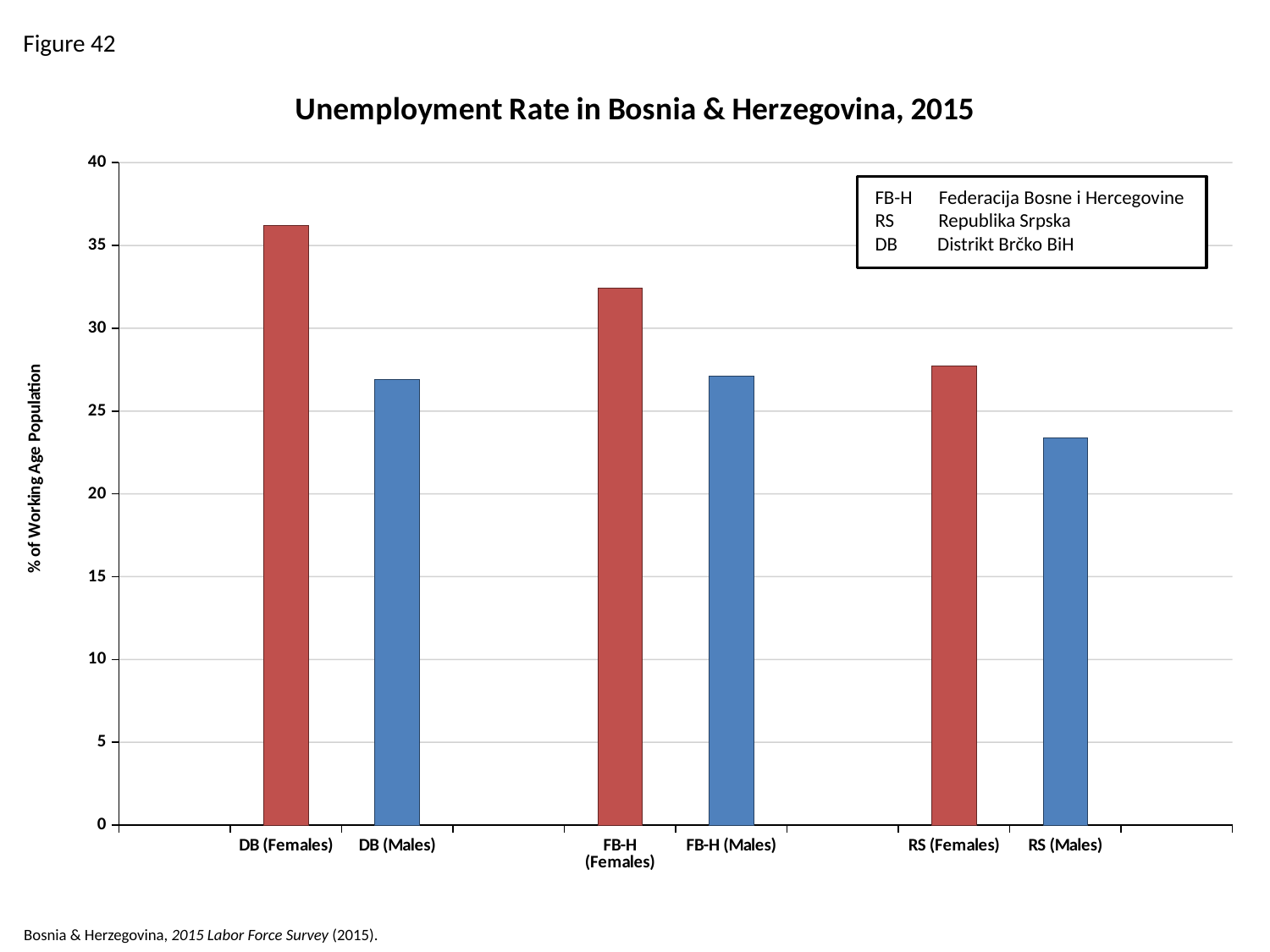
According to the legend box, what does the abbreviation RS stand for? Republika Srpska Is the value for DB (Males) greater or less than 30? less Which is larger, the value for DB (Females) or the value for FB-H (Females)? DB (Females) Which category has the highest unemployment rate? DB (Females) Is the value for DB (Females) greater or less than 35? greater Which is larger, the value for RS (Females) or the value for RS (Males)? RS (Females) Is the value for FB-H (Females) greater or less than 30? greater What is the title of the chart? Unemployment Rate in Bosnia & Herzegovina, 2015 What kind of chart is shown on the slide? bar chart How many bars are plotted in the chart? 6 Which category has the lowest unemployment rate? RS (Males)